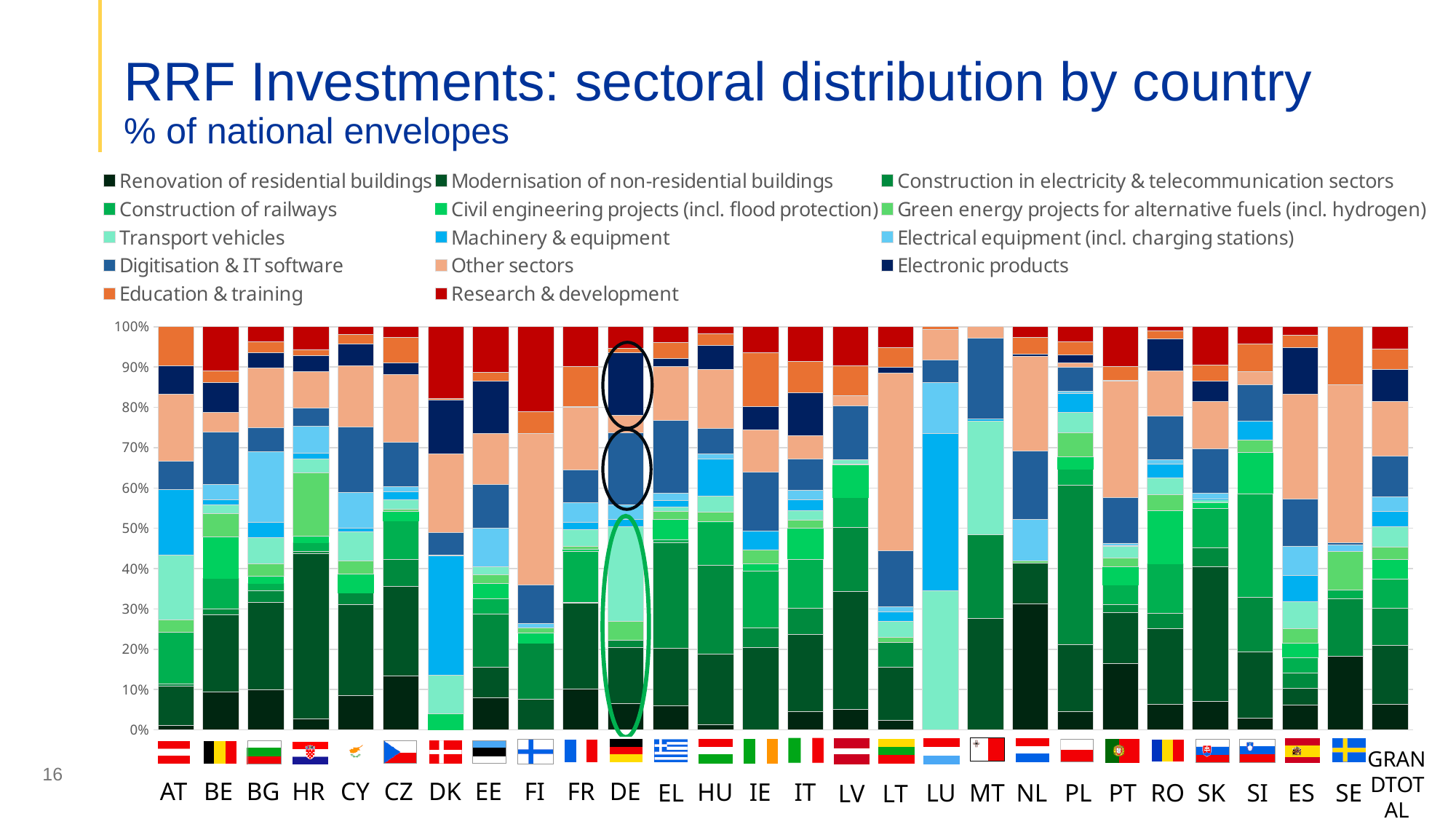
Is the Research & development share for FI greater or less than 10%? greater What unit does the subtitle say the values are expressed in? % of national envelopes What is the title of the slide's chart? RRF Investments: sectoral distribution by country How many series does the chart legend list? 14 Is the Other sectors share for LT greater or less than 30%? greater Which has the larger Renovation of residential buildings share, NL or AT? NL Is the Machinery & equipment share for LU greater or less than 30%? greater Which country has the largest Machinery & equipment share? LU What kind of chart is shown on the slide? Stacked bar chart How many countries/categories are shown along the x axis of the chart (including the grand total)? 28